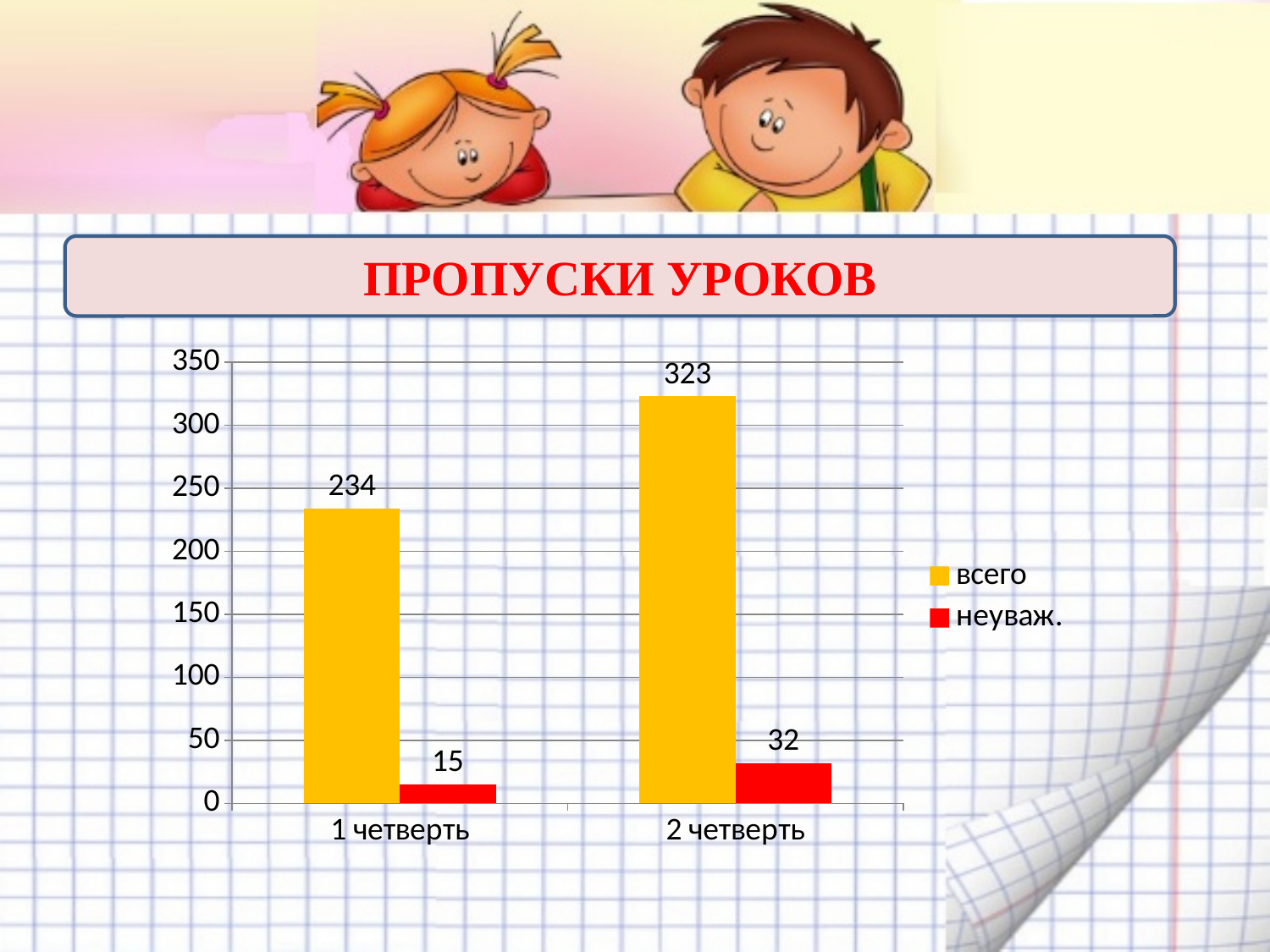
What kind of chart is shown on the slide? bar chart What is the value of "неуваж." for "2 четверть"? 32 Which category has the lowest value for "неуваж."? 1 четверть What is the value of "всего" for "2 четверть"? 323 What is the value of "всего" for "1 четверть"? 234 Which is larger: "всего" for "1 четверть" or "всего" for "2 четверть"? 2 четверть What is the value of "неуваж." for "1 четверть"? 15 What is the difference between the "неуваж." values for "2 четверть" and "1 четверть"? 17 What is the difference between the "всего" values for "2 четверть" and "1 четверть"? 89 How many series does the legend list? 2 Which category has the highest value for "всего"? 2 четверть How many categories are shown on the x axis? 2